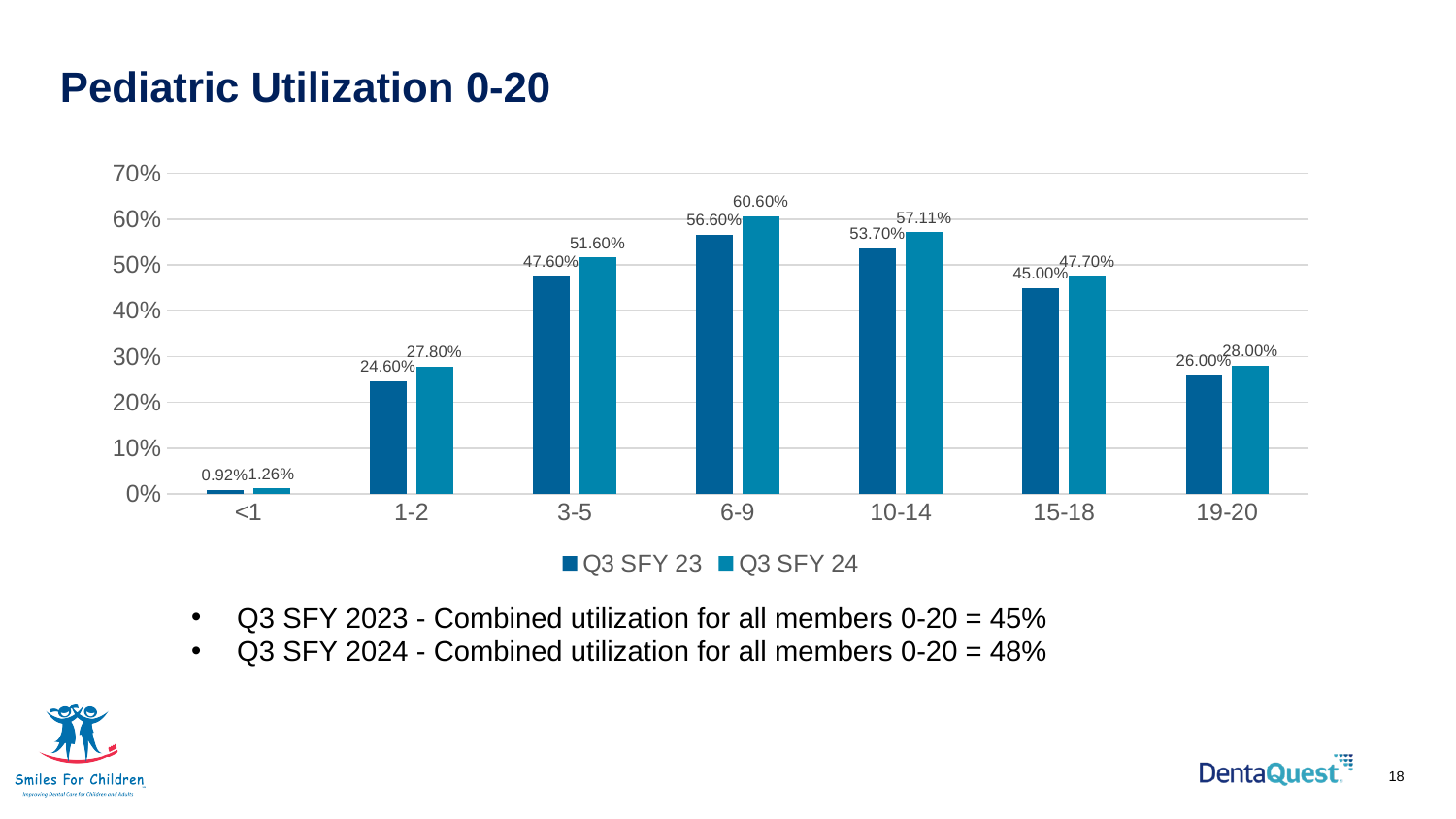
How many age groups are shown on the x axis? 7 What is the title of the chart on the slide? Pediatric Utilization 0-20 Which age group has the lowest Q3 SFY 23 utilization? <1 Is the Q3 SFY 23 value for the 3-5 age group greater or less than 40%? greater What kind of chart is shown on the slide? Bar chart What is the Q3 SFY 24 utilization value for the 6-9 age group? 60.60% What is the difference between the Q3 SFY 24 and Q3 SFY 23 values for the 1-2 age group? 3.20% What is the Q3 SFY 23 utilization value for the 10-14 age group? 53.70% Which is larger for the 15-18 age group: the Q3 SFY 23 value or the Q3 SFY 24 value? Q3 SFY 24 How many series does the legend list? 2 What is the Q3 SFY 23 value for the <1 age group? 0.92% Which age group has the highest Q3 SFY 24 utilization? 6-9